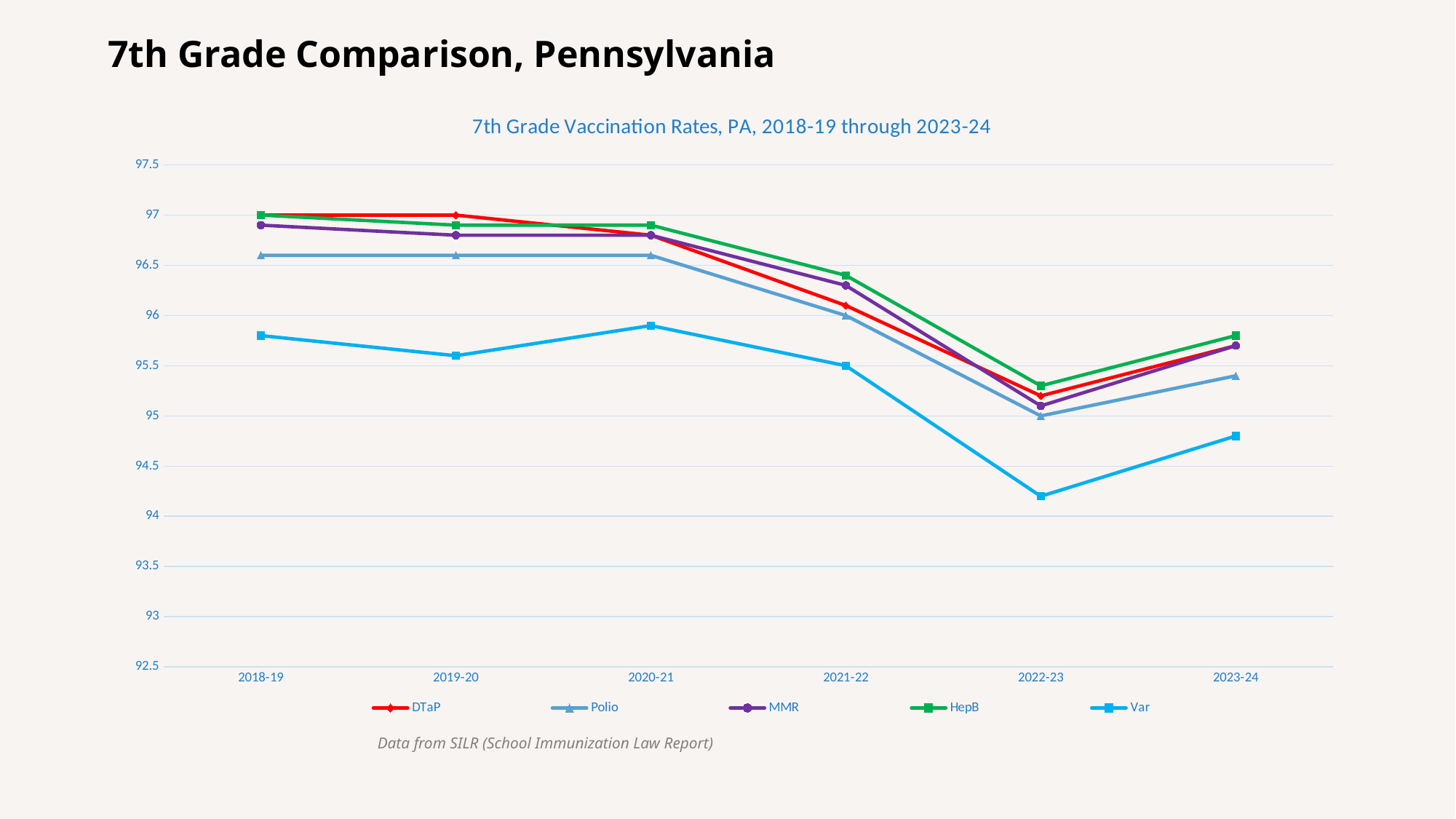
How many school years are shown on the x axis? 6 Does the Var series rise or fall from 2020-21 to 2022-23? fall How many series does the legend list? 5 Is the value for DTaP in 2022-23 greater or less than 95.5? less Is the value for HepB in 2023-24 greater or less than 95.5? greater Is the value for Var in 2022-23 greater or less than 94.5? less Which is larger in 2023-24, the Polio value or the Var value? Polio In which school year does the Var series reach its lowest value? 2022-23 Which series has the lowest value in 2022-23? Var What is the title of the chart? 7th Grade Vaccination Rates, PA, 2018-19 through 2023-24 What kind of chart is shown on the slide? line chart